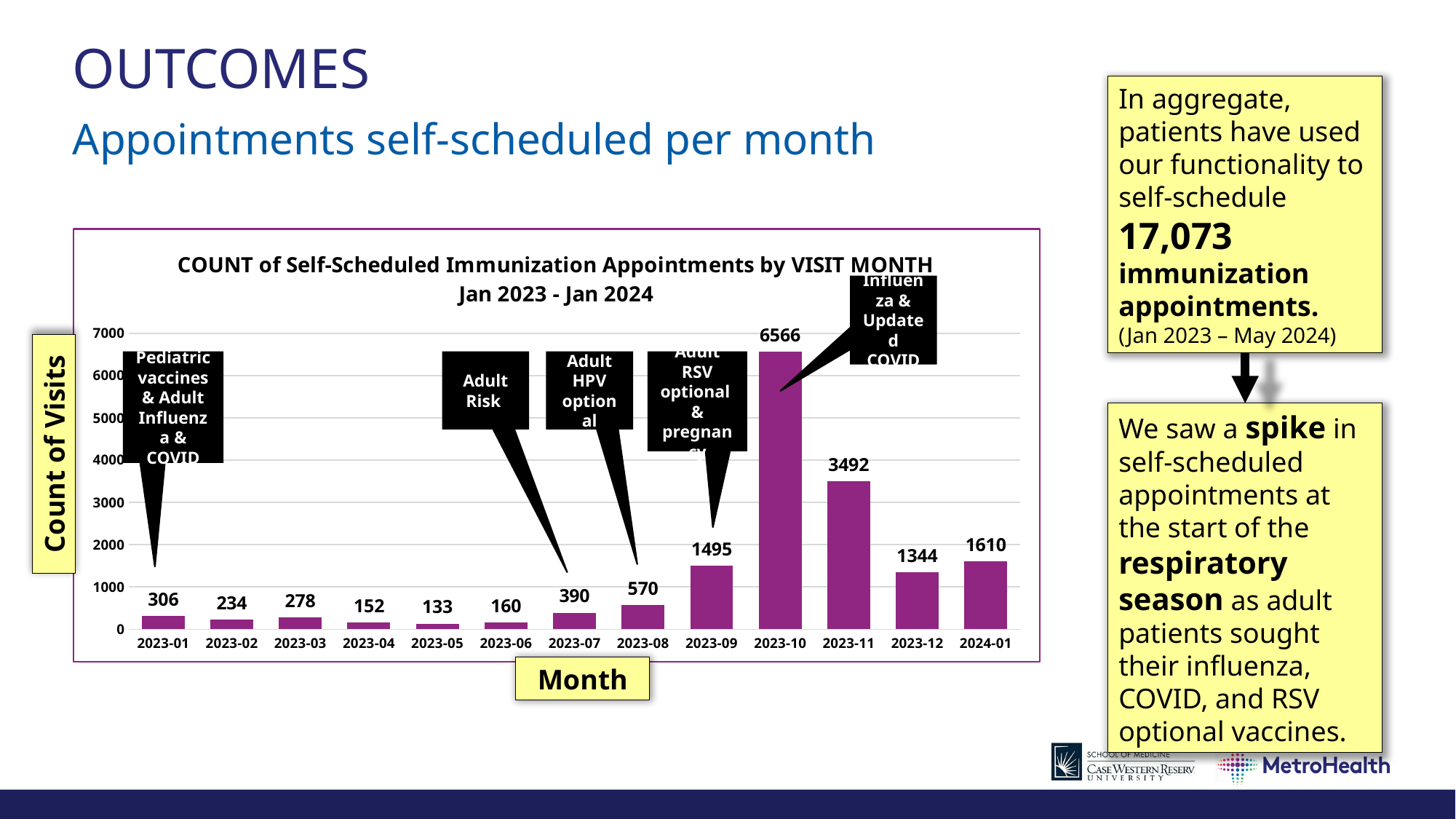
What kind of chart is shown on the slide? Bar chart Which month has a higher count, 2023-09 or 2023-12? 2023-09 What is the count of visits for 2024-01? 1610 Is the value for 2023-11 greater or less than 3000? greater What is the count of self-scheduled immunization appointments for 2023-10? 6566 Do the counts rise or fall from 2023-10 to 2023-12? Fall What is the count of visits for 2023-01? 306 What is the label on the y axis of the chart? Count of Visits Which month has the lowest count of self-scheduled immunization appointments? 2023-05 What is the difference between the counts for 2023-10 and 2023-11? 3074 How many months are shown on the x axis of the chart? 13 Which month has the highest count of self-scheduled immunization appointments? 2023-10